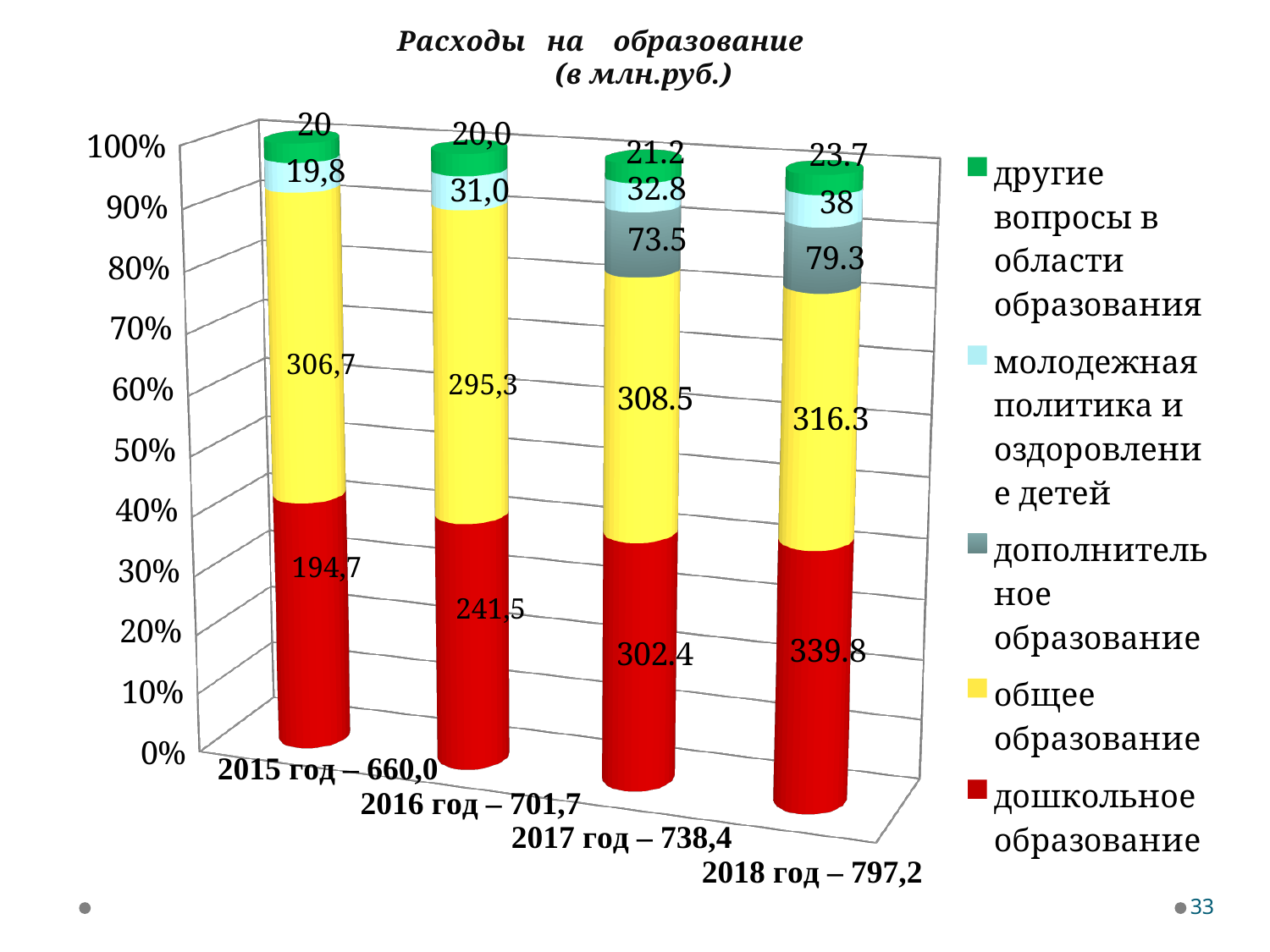
In which year is the value for дошкольное образование the highest? 2018 год What is the difference between the дошкольное образование values for 2018 год and 2017 год? 37.4 What is the value for молодежная политика и оздоровление детей in 2016 год? 31,0 How many series does the legend list? 5 What is the value for общее образование in 2018 год? 316.3 What is the total for 2017 год as shown in the category label? 738,4 What is the value for дошкольное образование in 2015 год? 194,7 In which year is the value for молодежная политика и оздоровление детей the lowest? 2015 год Which is larger in 2016 год: общее образование or дошкольное образование? общее образование What kind of chart is shown on the slide? stacked bar chart What is the value for дополнительное образование in 2017 год? 73.5 How many years (categories) are shown on the x axis? 4